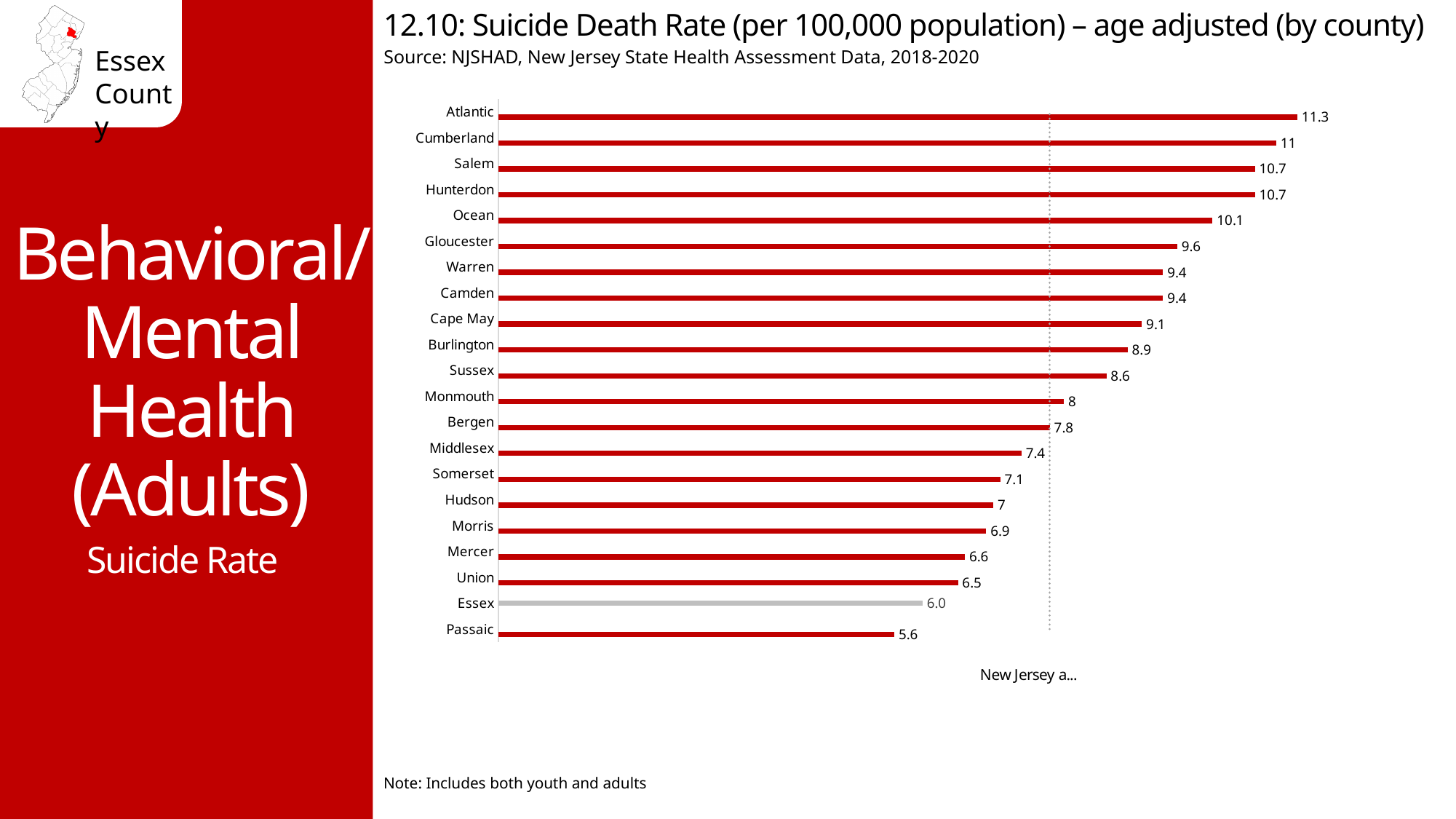
Which county has a higher suicide death rate, Ocean or Gloucester? Ocean What is the difference between the suicide death rates of Union and Essex counties? 0.5 Which county has a higher suicide death rate, Hudson or Mercer? Hudson What type of chart is shown on the slide? Bar chart What is the difference between the suicide death rates of Atlantic and Passaic counties? 5.7 Which county's bar is shown in grey instead of red? Essex What is the suicide death rate for Bergen County? 7.8 Which county has the highest suicide death rate? Atlantic How many counties are shown in the chart? 21 What is the suicide death rate for Essex County? 6.0 What is the suicide death rate for Atlantic County? 11.3 Which county has the lowest suicide death rate? Passaic